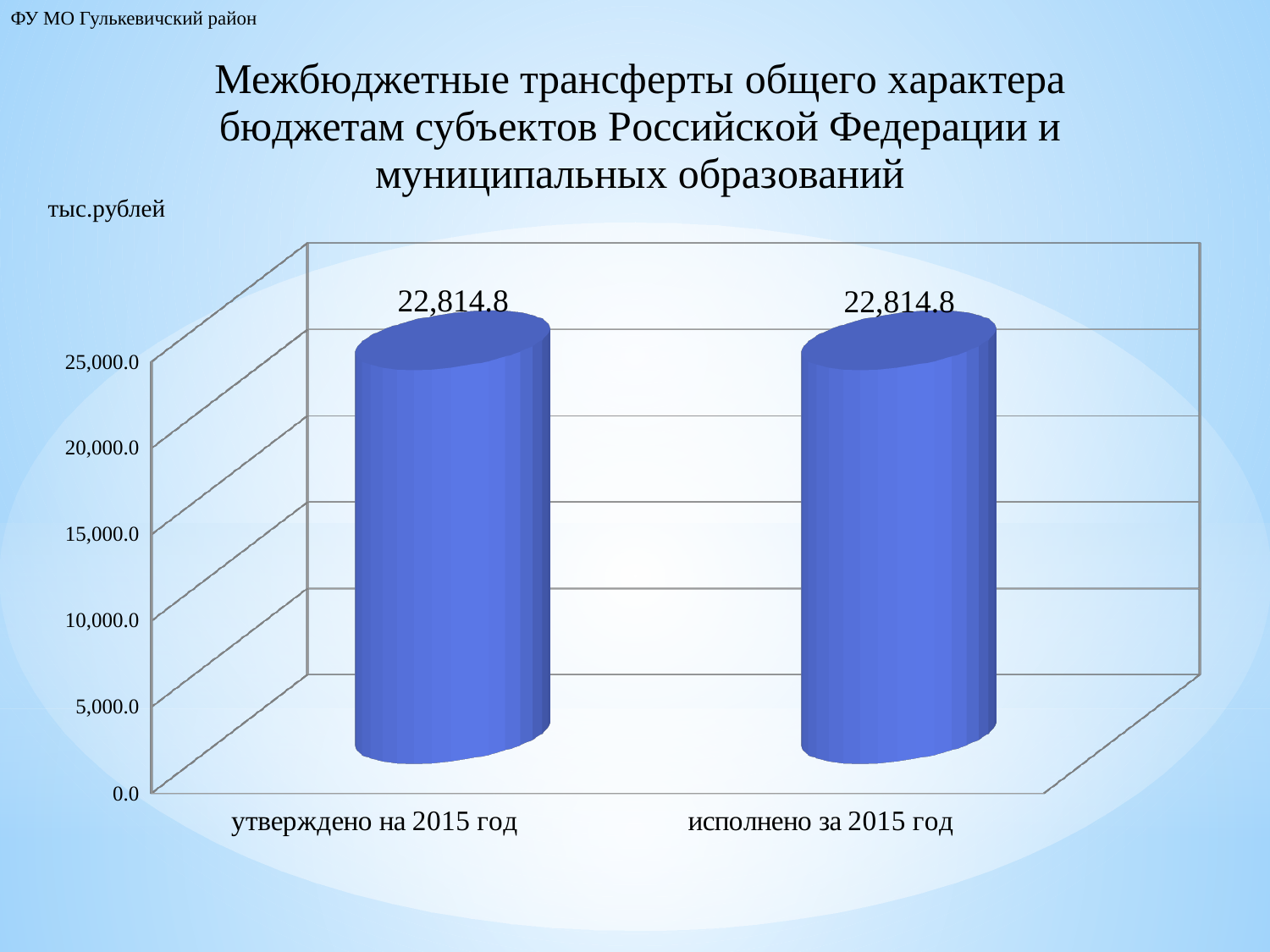
What is the total of the two values shown on the chart? 45,629.6 Is the value for "утверждено на 2015 год" greater or less than 20,000.0? greater What kind of chart is shown on the slide? bar chart What unit of measurement is indicated above the chart? тыс.рублей How many categories are shown on the chart? 2 Is the value for "исполнено за 2015 год" larger than, smaller than, or equal to the value for "утверждено на 2015 год"? equal What is the value for "исполнено за 2015 год"? 22,814.8 What is the highest value labelled on the vertical axis? 25,000.0 What is the difference between the value for "утверждено на 2015 год" and the value for "исполнено за 2015 год"? 0.0 What is the value for "утверждено на 2015 год"? 22,814.8 Is the value for "исполнено за 2015 год" greater or less than 25,000.0? less